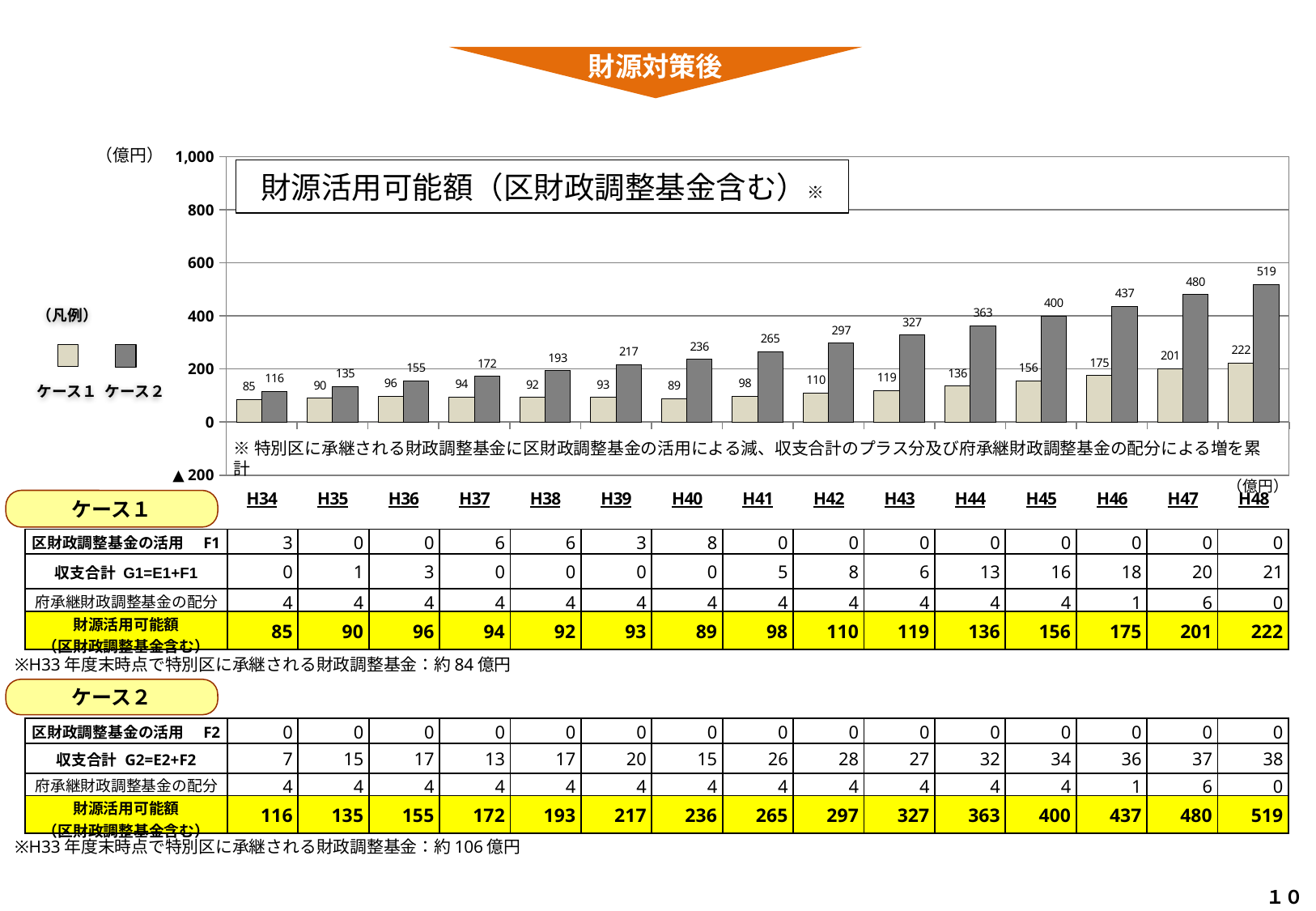
How many series does the legend list? 2 What kind of chart is shown on the slide? bar chart Which year has the lowest value for ケース1? H34 What is the difference between ケース2 and ケース1 in H48? 297 Which is larger in H45: ケース1 or ケース2? ケース2 Which year has the highest value for ケース2? H48 What is the value for ケース2 in H48? 519 What is the value for ケース1 in H42? 110 What is the value for ケース2 in H39? 217 Do the values for ケース2 rise or fall from H34 to H48? rise Is the value for ケース2 in H46 greater or less than 400? greater How many years are shown on the x axis of the chart? 15